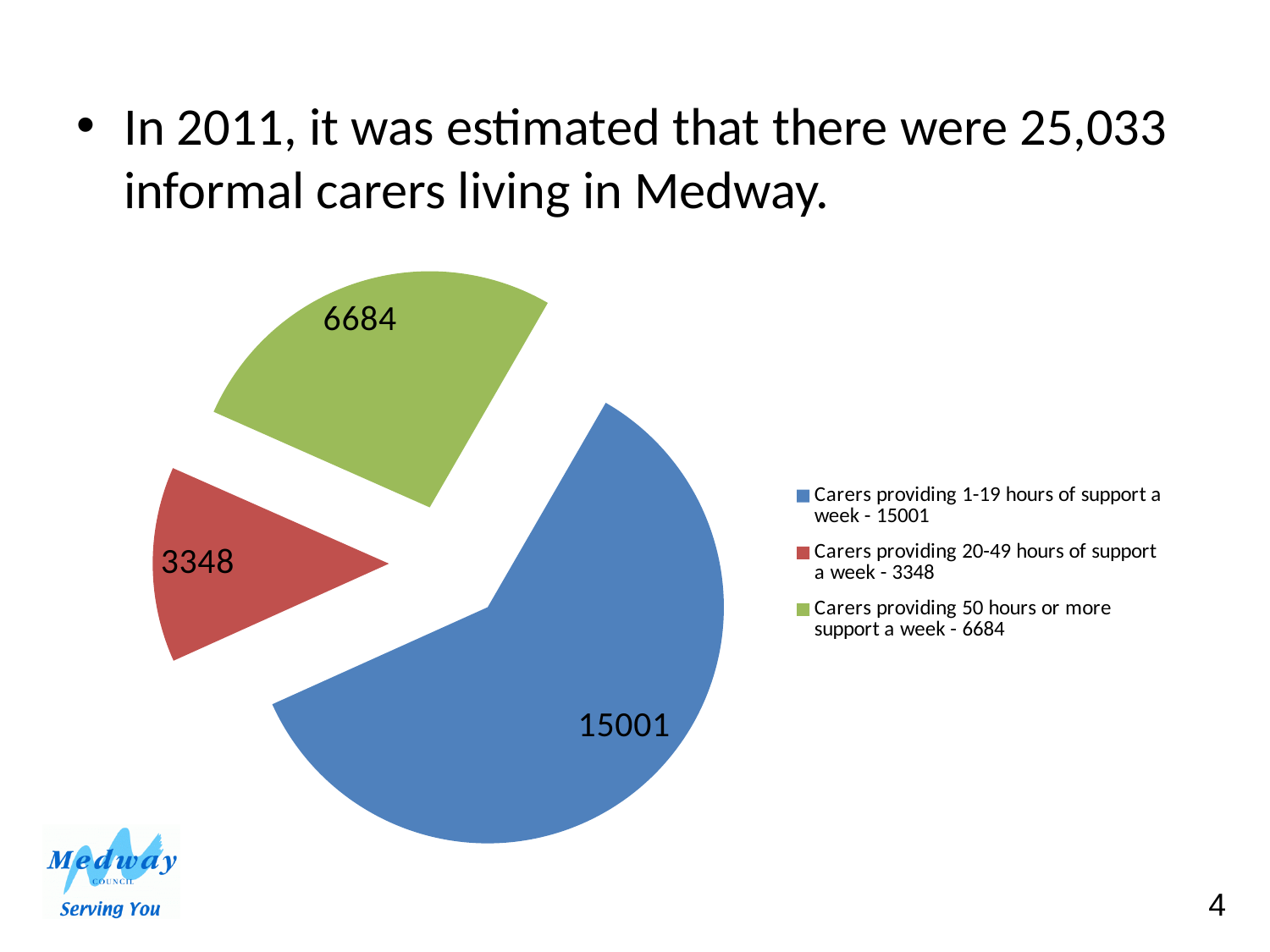
How many entries does the legend of the pie chart list? 3 What is the difference between the number of carers providing 1-19 hours of support a week and those providing 50 hours or more? 8317 What is the value for carers providing 1-19 hours of support a week? 15001 What is the value for carers providing 50 hours or more support a week? 6684 Which category has the smallest slice of the pie chart? Carers providing 20-49 hours of support a week Which category has the largest slice of the pie chart? Carers providing 1-19 hours of support a week Which is larger: the number of carers providing 50 hours or more support a week or those providing 20-49 hours? Carers providing 50 hours or more support a week What is the value for carers providing 20-49 hours of support a week? 3348 What colour is the slice for carers providing 50 hours or more support a week? Green How many slices does the pie chart have? 3 What is the total of all three slices in the pie chart? 25033 What kind of chart is shown on the slide? Pie chart